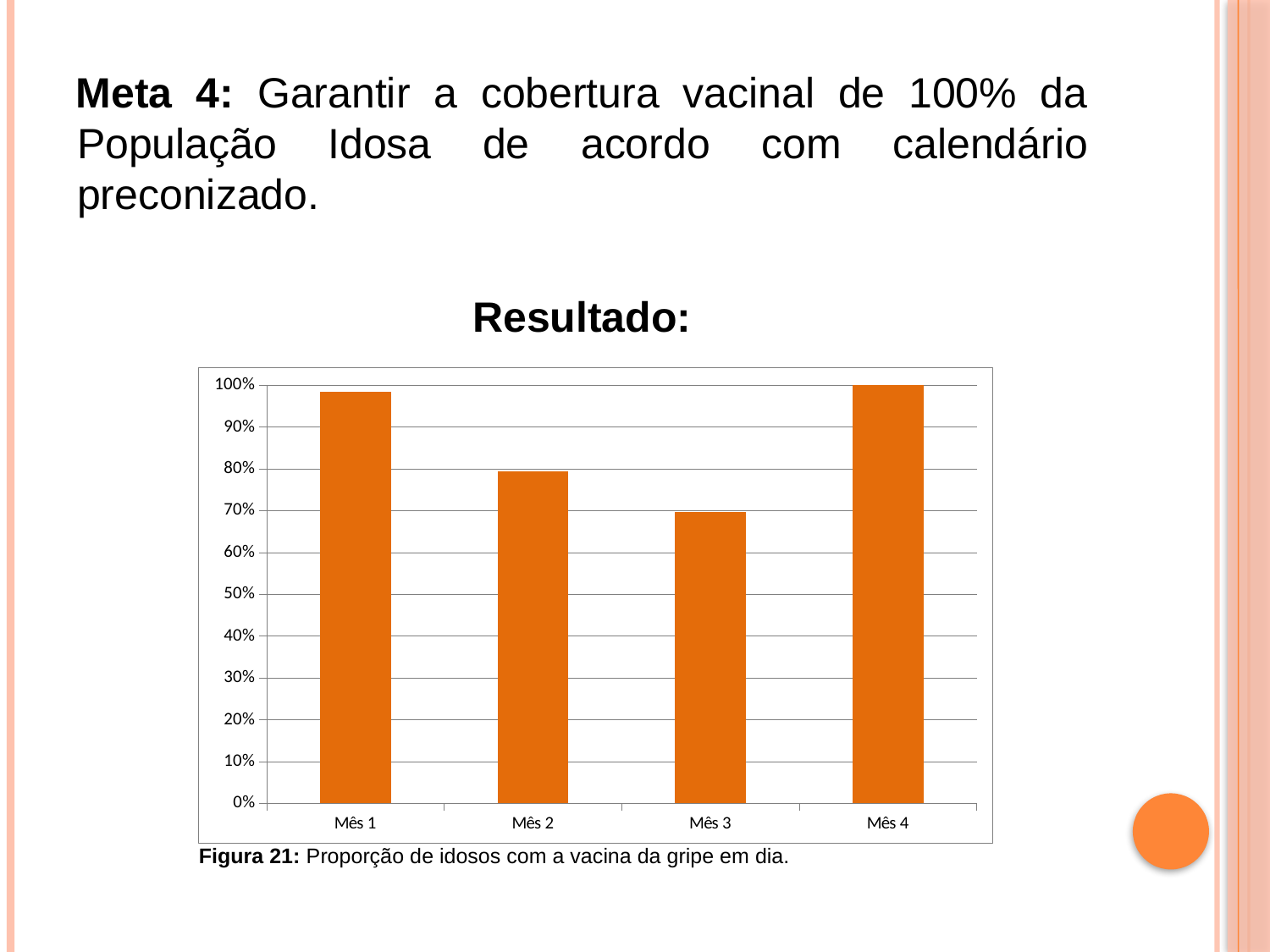
Which month has the highest proportion of elderly with the flu vaccine up to date? Mês 4 Is the value for Mês 1 greater or less than 90%? greater Which is larger, the value for Mês 2 or the value for Mês 3? Mês 2 What is the value for Mês 4? 100% What kind of chart is shown on the slide? Bar chart Which is larger, the value for Mês 1 or the value for Mês 2? Mês 1 Which month has the lowest value in the chart? Mês 3 Do the values fall or rise from Mês 1 to Mês 3? fall What is the figure caption below the chart? Figura 21: Proporção de idosos com a vacina da gripe em dia. Is the value for Mês 3 greater or less than 80%? less How many months (categories) are shown on the x axis of the chart? 4 Is the value for Mês 2 greater or less than 70%? greater